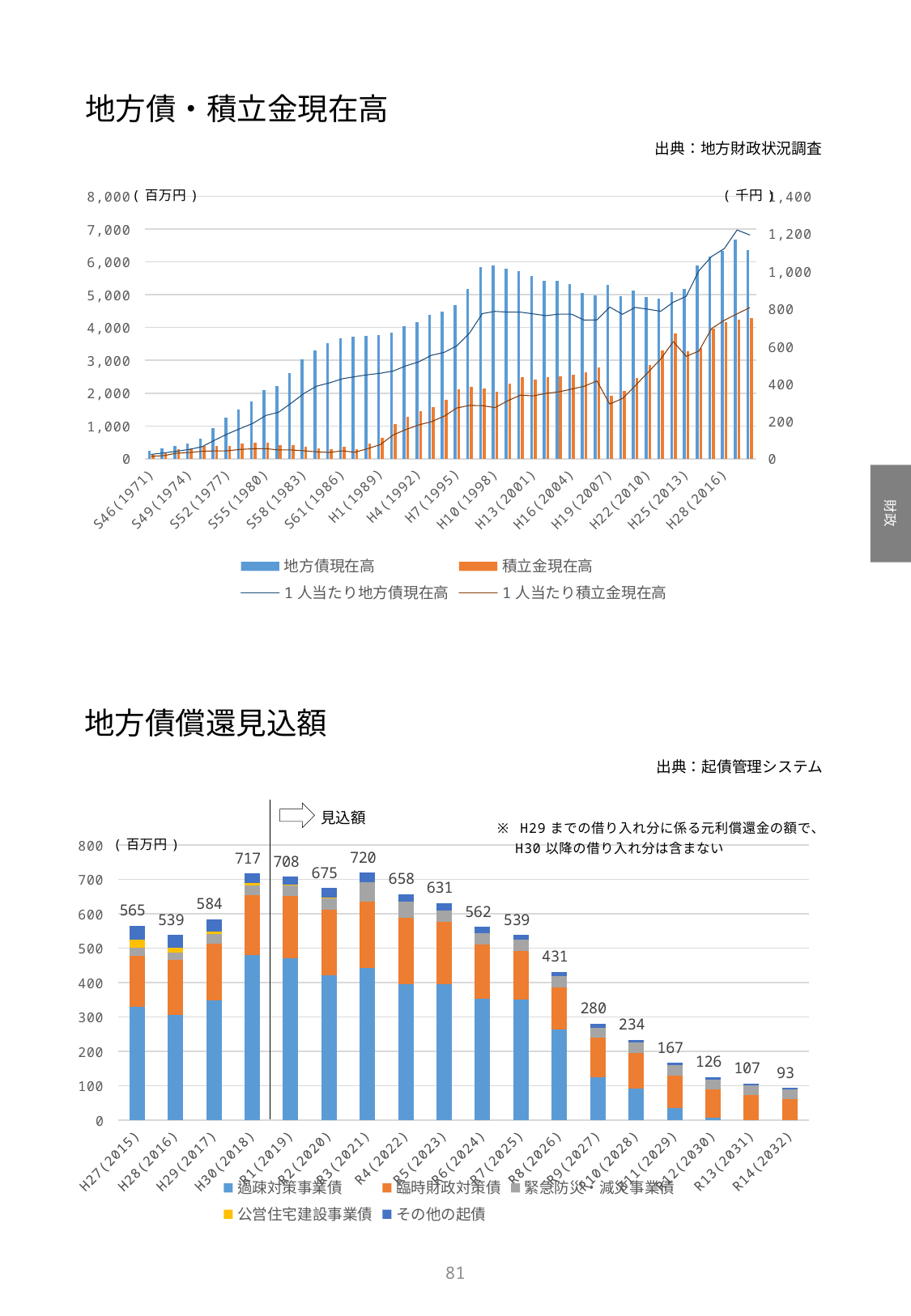
In the 地方債償還見込額 chart, what is the difference between the totals for R3(2021) and R4(2022)? 62 In the 地方債償還見込額 chart, do the totals rise or fall from R3(2021) to R14(2032)? Fall In the 地方債償還見込額 chart, which year has the lowest total? R14(2032) What kind of chart is the 地方債償還見込額 chart? Stacked bar chart In the 地方債・積立金現在高 chart, is the 地方債現在高 bar for H10(1998) greater or less than 5,000? greater In the 地方債償還見込額 chart, how many years are shown on the x axis? 18 In the 地方債償還見込額 chart, what is the total value for R9(2027)? 280 In the 地方債償還見込額 chart, what is the total value for H30(2018)? 717 In the 地方債・積立金現在高 chart, how many entries does the legend list? 4 In the 地方債償還見込額 chart, how many series does the legend list? 5 In the 地方債償還見込額 chart, which is larger, the total for H27(2015) or the total for R6(2024)? H27(2015) In the 地方債償還見込額 chart, which year has the highest total? R3(2021)